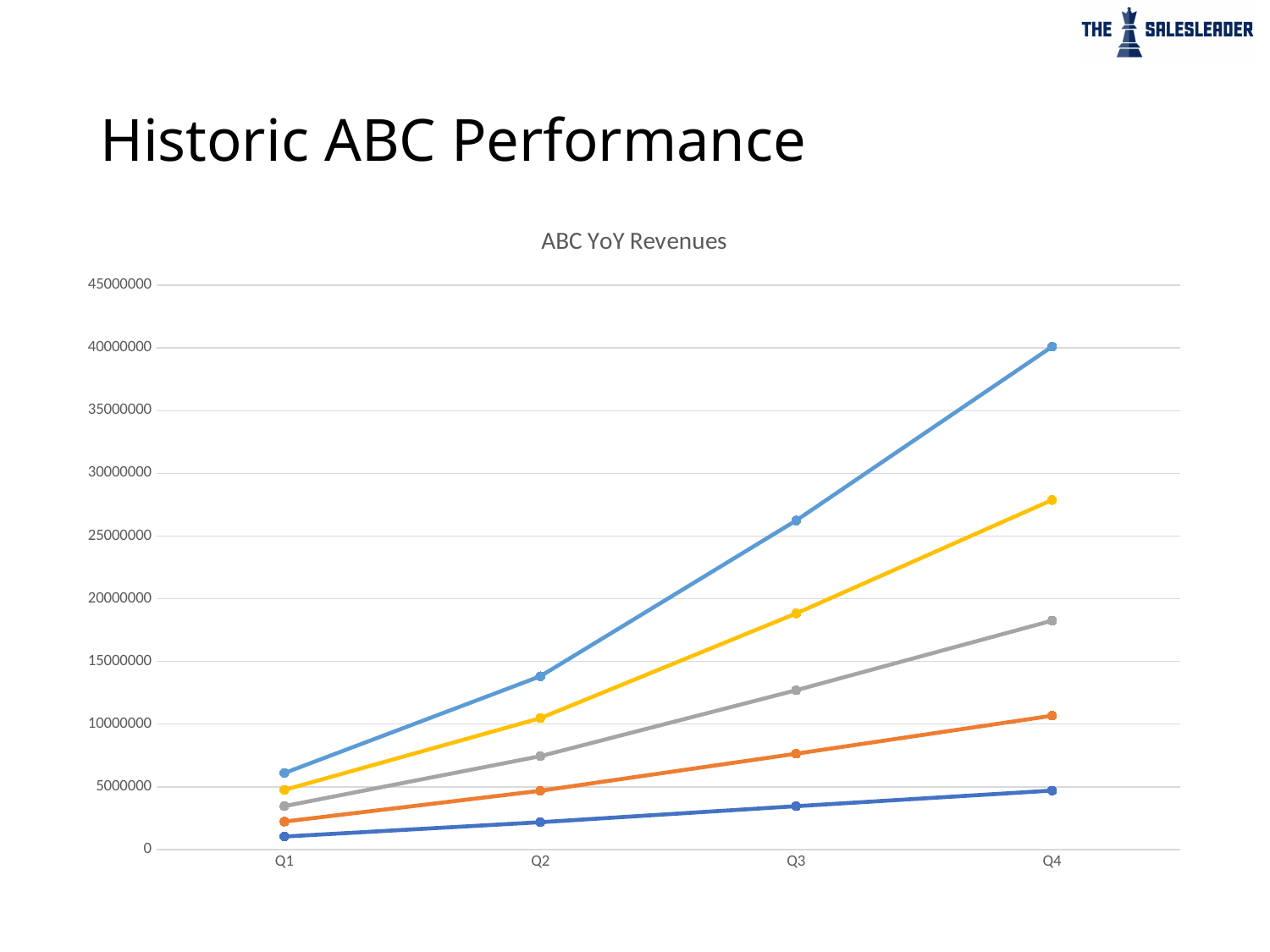
Which line has the highest value at Q4? the light blue line Is the value of the yellow line at Q4 greater or less than 25000000? greater What is the title of the chart? ABC YoY Revenues At Q3, which is larger: the value of the yellow line or the value of the grey line? the yellow line How many lines are plotted on the chart? 5 Which line has the lowest value at Q4? the dark blue line Is the value of the grey line at Q4 greater or less than 20000000? less Do the values of the light blue line rise or fall from Q1 to Q4? rise What kind of chart is shown on the slide? line chart Is the value of the light blue line at Q3 greater or less than 25000000? greater How many quarters are shown on the x axis? 4